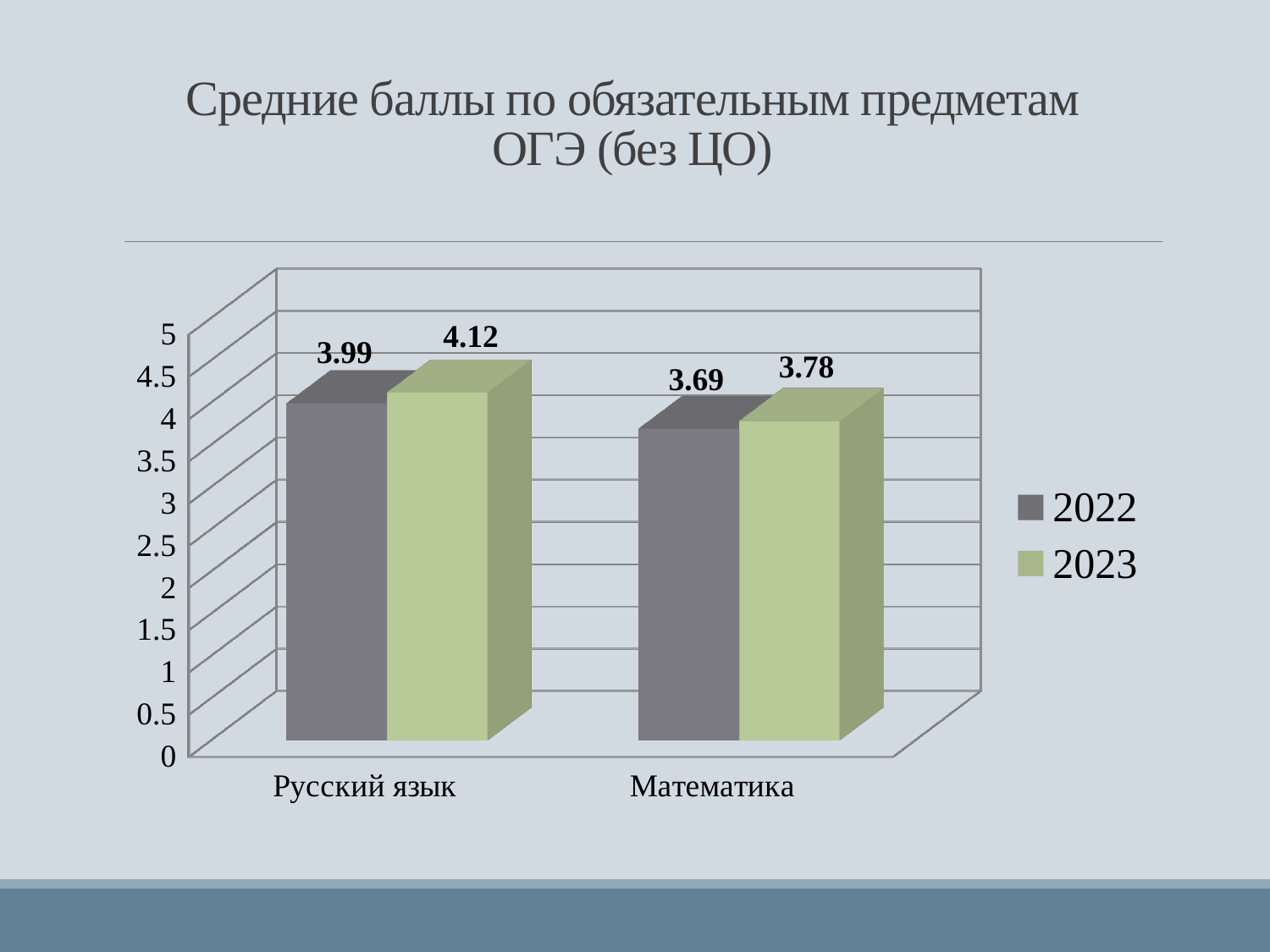
How many series does the legend list? 2 What is the difference between the 2023 and 2022 values for Математика? 0.09 What is the value for Русский язык in 2022? 3.99 What is the value for Математика in 2023? 3.78 Which is larger: the 2022 value for Русский язык or the 2023 value for Математика? 2022 value for Русский язык Which subject has the highest value in 2023? Русский язык What is the value for Математика in 2022? 3.69 What is the value for Русский язык in 2023? 4.12 How many subjects are shown on the x axis? 2 Which subject has the lowest value in 2022? Математика What kind of chart is shown on the slide? Bar chart What is the difference between the 2023 and 2022 values for Русский язык? 0.13